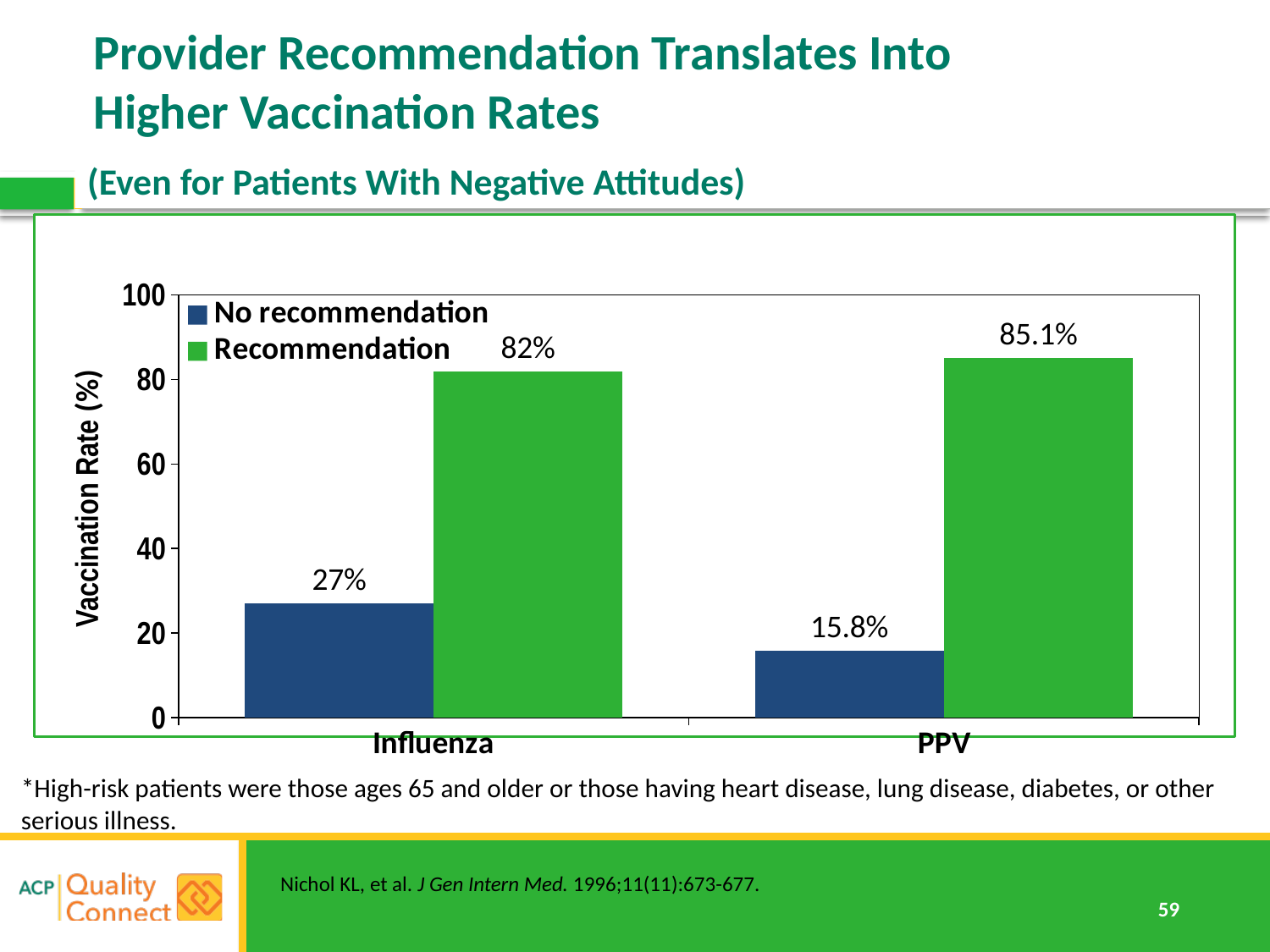
Is the Recommendation value for PPV greater or less than 80? greater What is the vaccination rate for Influenza with no recommendation? 27% What kind of chart is shown on the slide? Bar chart What is the vaccination rate for PPV with a recommendation? 85.1% What is the vaccination rate for PPV with no recommendation? 15.8% How many vaccine categories are shown on the x axis? 2 What is the difference between the Recommendation and No recommendation vaccination rates for Influenza? 55 percentage points Which bar shows the lowest vaccination rate? PPV, No recommendation Which bar shows the highest vaccination rate? PPV, Recommendation Which is larger: the No recommendation rate for Influenza or the No recommendation rate for PPV? Influenza How many series does the legend list? 2 What is the vaccination rate for Influenza with a recommendation? 82%